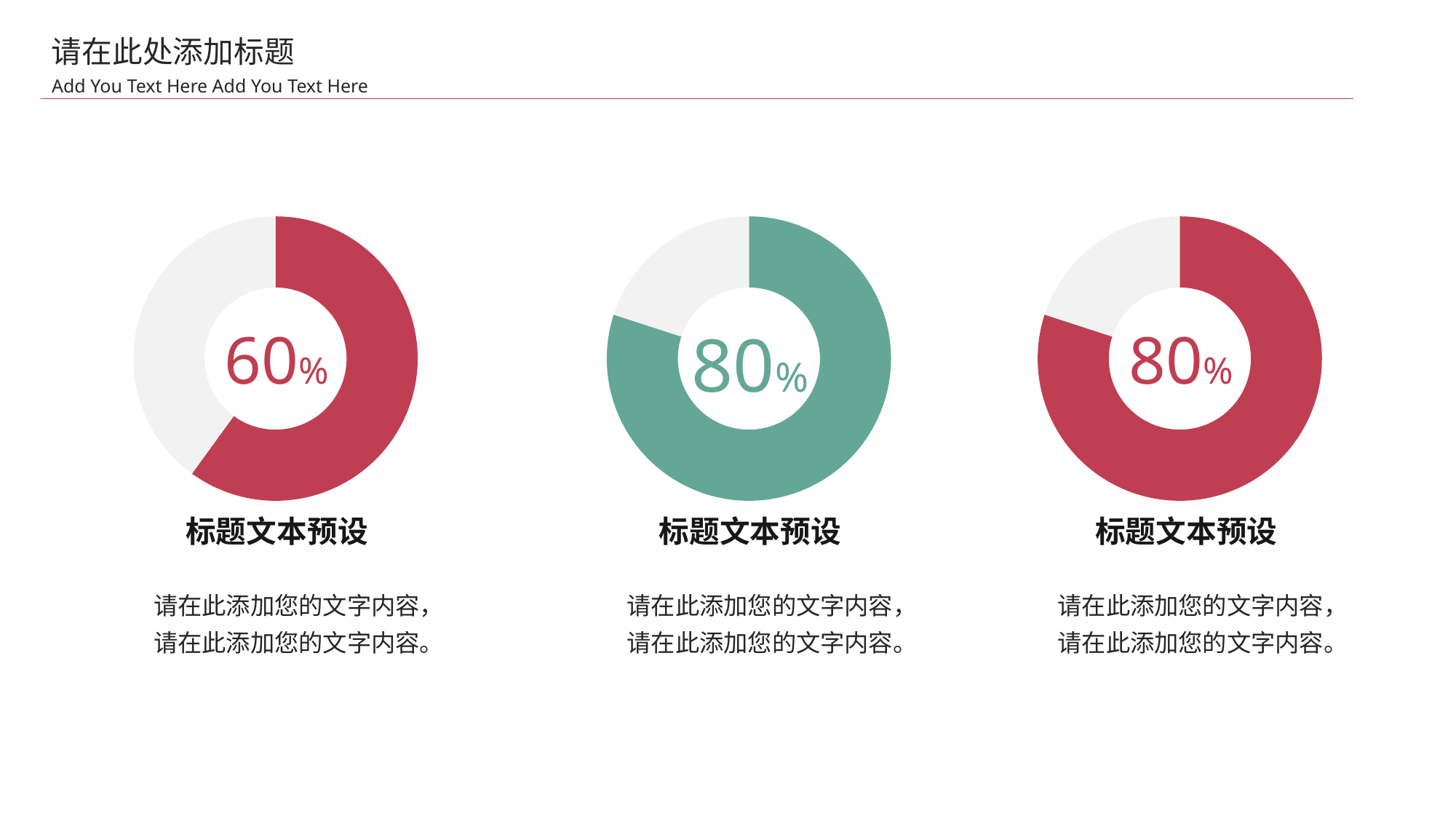
Which donut chart shows the lowest percentage: the left, middle or right one? Left What kind of chart is used on this slide? Donut chart What is the difference between the percentage in the middle donut chart and the percentage in the left donut chart? 20% Do the middle and right donut charts show the same percentage? Yes How many donut charts are on the slide? 3 What value is shown in the centre of the right donut chart? 80% What value is shown in the centre of the middle donut chart? 80% What colour is the filled portion of the middle donut chart? Green What value is shown in the centre of the left donut chart? 60% What share of the left donut chart is left unfilled (grey)? 40% What colour is the filled portion of the left donut chart? Red Is the value in the left donut chart larger or smaller than the value in the right donut chart? Smaller